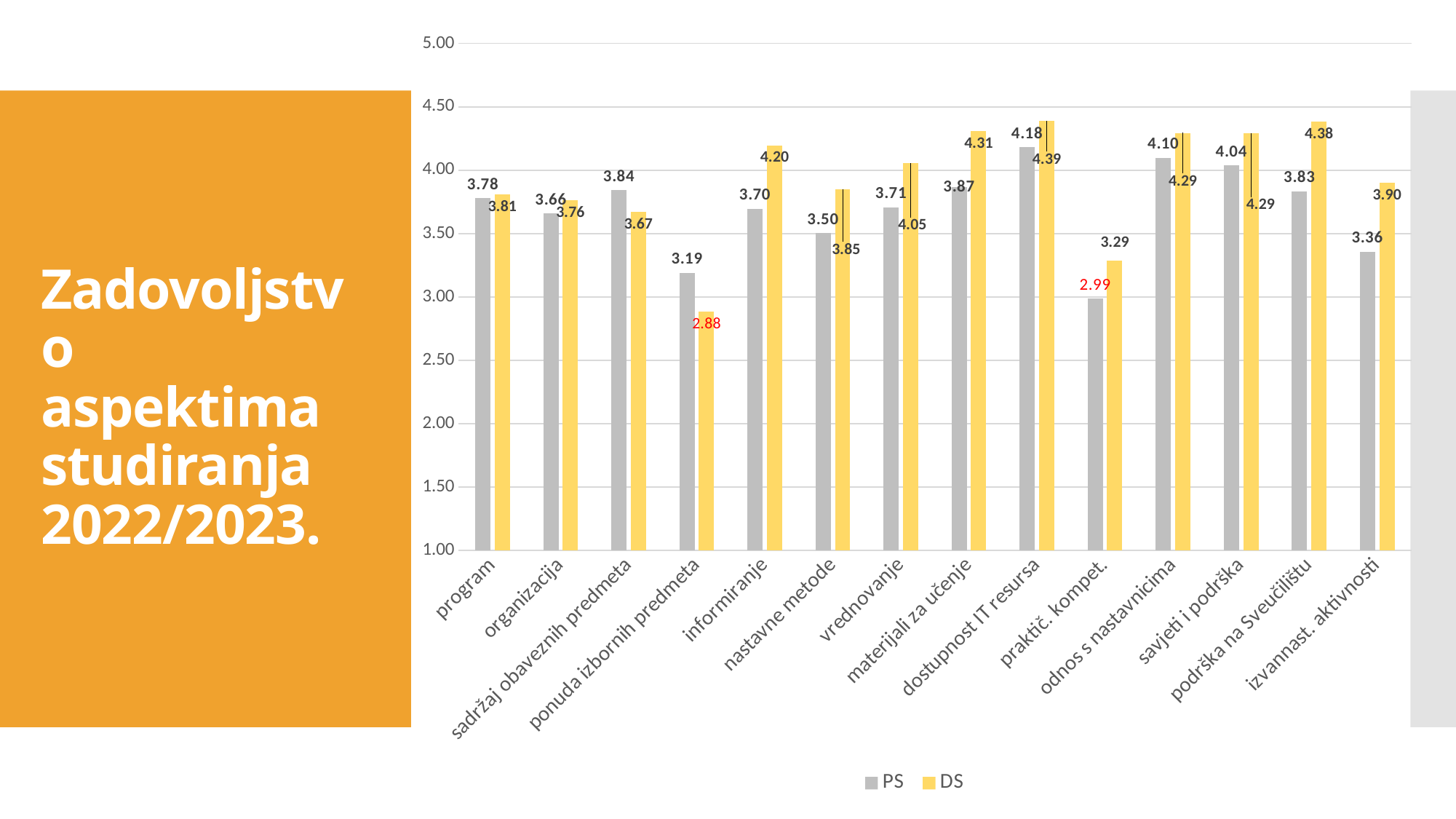
Is the PS value for 'izvannast. aktivnosti' greater or less than 3.50? less What is the difference between the DS and PS values for 'informiranje'? 0.50 What is the DS value for 'ponuda izbornih predmeta'? 2.88 Which category has the lowest DS value? ponuda izbornih predmeta What is the PS value for 'program'? 3.78 For 'sadržaj obaveznih predmeta', which series has the larger value, PS or DS? PS How many categories are shown on the x axis? 14 Which category has the highest PS value? dostupnost IT resursa What is the DS value for 'informiranje'? 4.20 How many series does the legend list? 2 Which category has the lowest PS value? praktič. kompet. What kind of chart is shown on the slide? bar chart